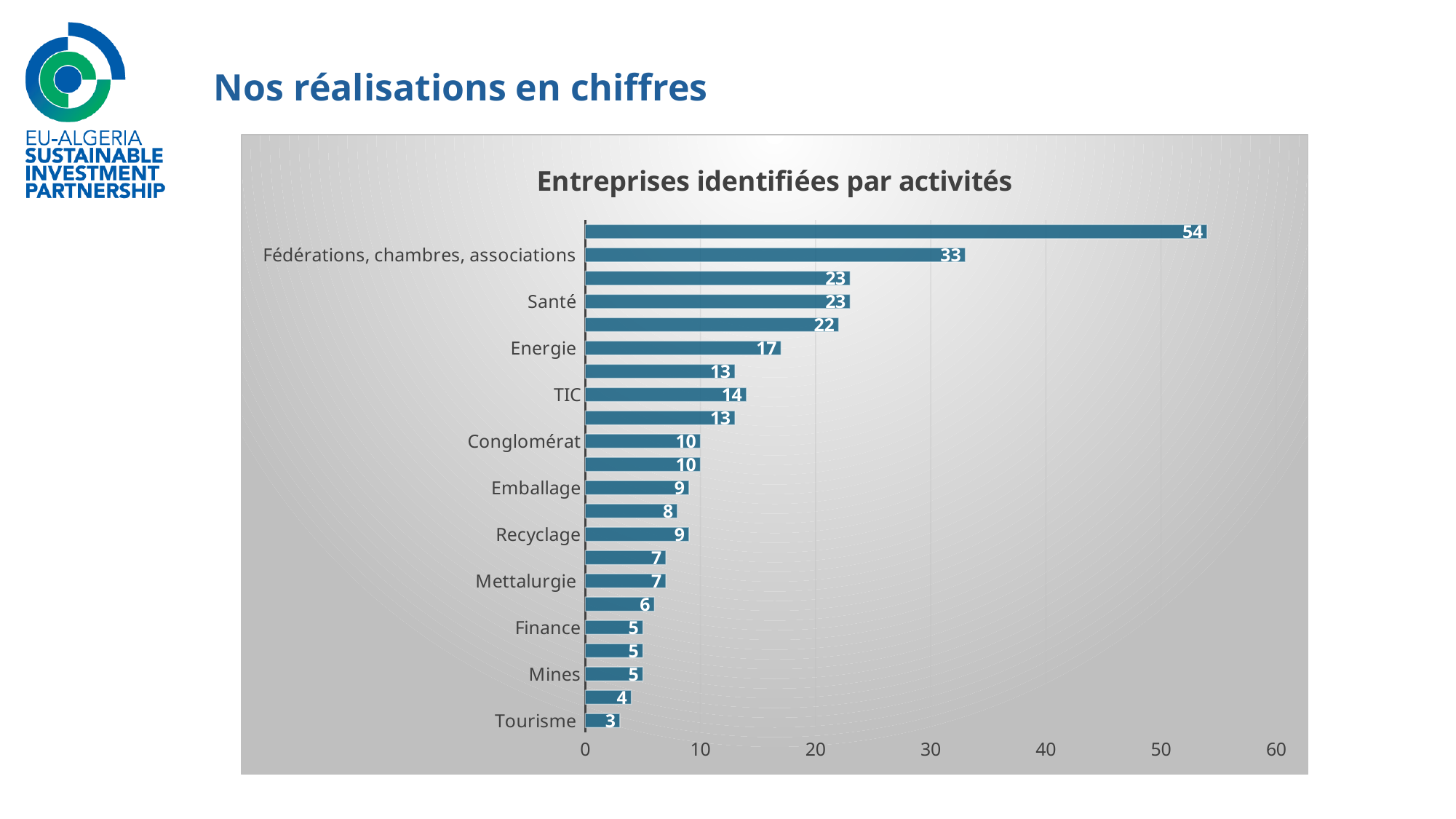
What is the value for TIC? 14 What is the value for Tourisme? 3 Which is larger, the value for Energie or the value for Conglomérat? Energie Which labelled category has the lowest value? Tourisme What is the value for Santé? 23 What type of chart is shown on the slide? bar chart How many bars are plotted on the chart? 22 What is the title of the chart? Entreprises identifiées par activités What is the value for Energie? 17 What is the largest value shown on the chart? 54 What is the difference between the values for Fédérations, chambres, associations and Santé? 10 What is the value for Fédérations, chambres, associations? 33